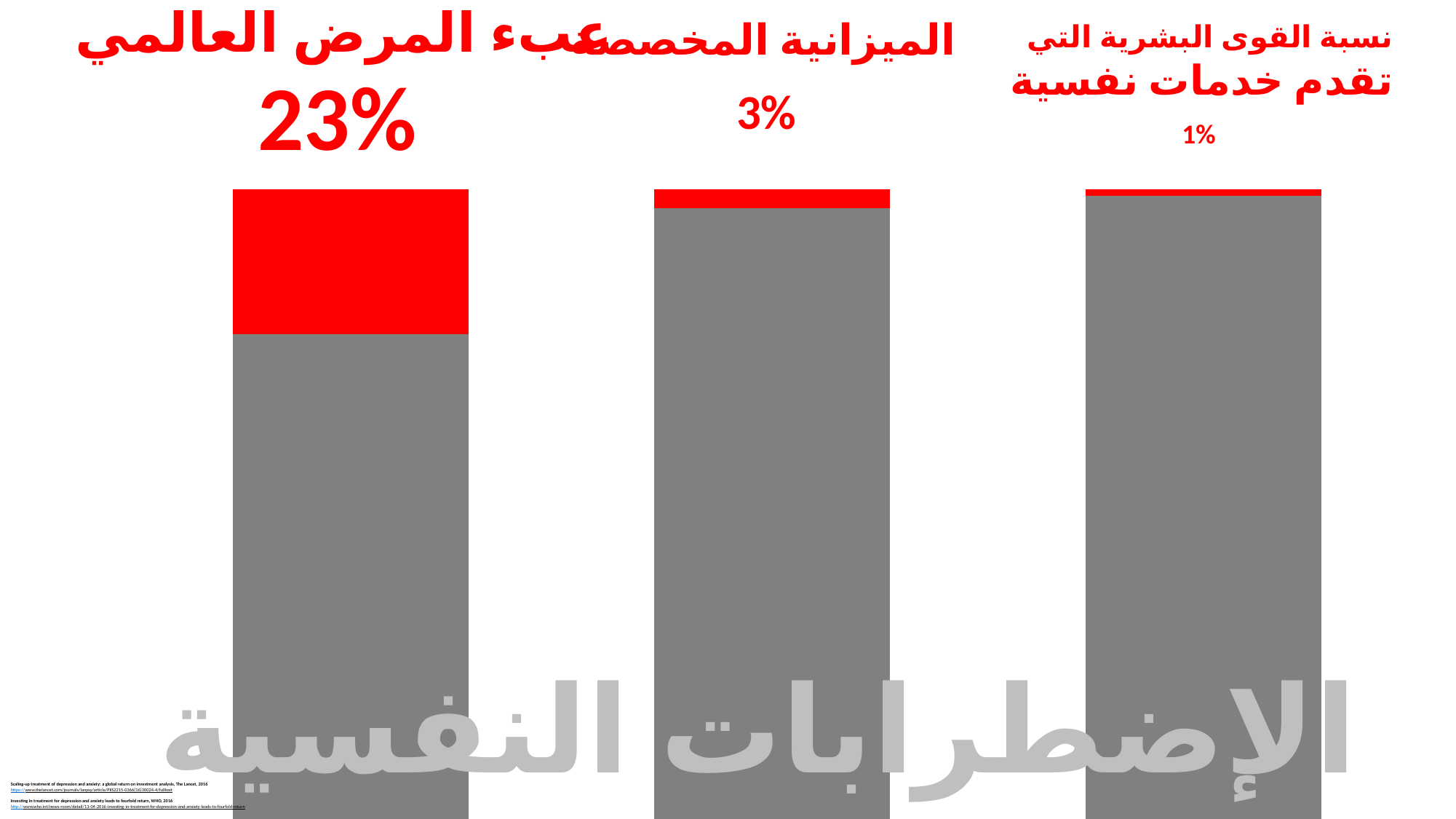
Which is larger, the percentage for الميزانية المخصصة or for نسبة القوى البشرية التي تقدم خدمات نفسية? الميزانية المخصصة Do the percentages rise or fall moving from the left bar to the right bar? Fall What kind of chart is shown on the slide? Bar chart Which bar has the smallest red portion? نسبة القوى البشرية التي تقدم خدمات نفسية (1%) What colour is used for the highlighted (percentage) portion of each bar? Red Which bar has the largest red portion? عبء المرض العالمي (23%) What percentage is shown above the middle bar (الميزانية المخصصة)? 3% How many bars are shown on the slide? 3 What percentage is shown above the right bar (نسبة القوى البشرية التي تقدم خدمات نفسية)? 1% What percentage is shown above the left bar (عبء المرض العالمي)? 23% What is the difference between the percentage for the middle bar (3%) and the right bar (1%)? 2% What is the difference between the percentage for the left bar (23%) and the middle bar (3%)? 20%